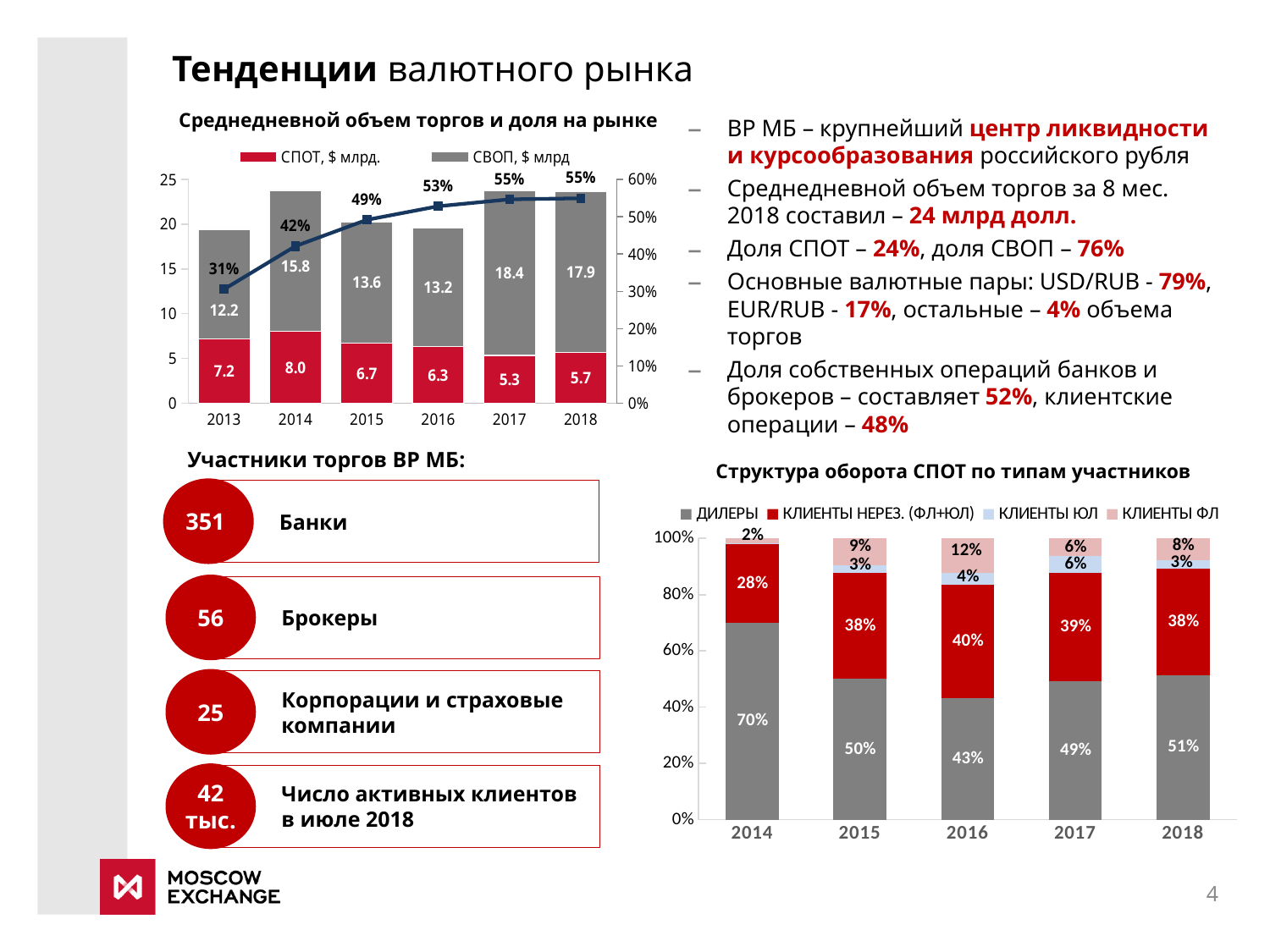
In the chart 'Среднедневной объем торгов и доля на рынке', does the line of percentages rise or fall from 2013 to 2017? rise In the chart 'Структура оборота СПОТ по типам участников', what is the share of ДИЛЕРЫ in 2016? 43% In the chart 'Среднедневной объем торгов и доля на рынке', which year has the lowest СПОТ value? 2017 In the chart 'Среднедневной объем торгов и доля на рынке', what is the СВОП value for 2017? 18.4 In the chart 'Среднедневной объем торгов и доля на рынке', what is the total of the stacked bar for 2018? 23.6 In the chart 'Среднедневной объем торгов и доля на рынке', what is the СПОТ value for 2014? 8.0 In the chart 'Структура оборота СПОТ по типам участников', is the share of КЛИЕНТЫ ФЛ larger in 2016 or in 2017? 2016 How many years are shown on the x axis of the chart 'Структура оборота СПОТ по типам участников'? 5 In the chart 'Среднедневной объем торгов и доля на рынке', what is the difference between the СВОП values for 2014 and 2013? 3.6 In the chart 'Структура оборота СПОТ по типам участников', which year has the highest share of ДИЛЕРЫ? 2014 In the chart 'Среднедневной объем торгов и доля на рынке', what percentage is shown on the line for 2015? 49% How many series does the legend of the chart 'Среднедневной объем торгов и доля на рынке' list? 2